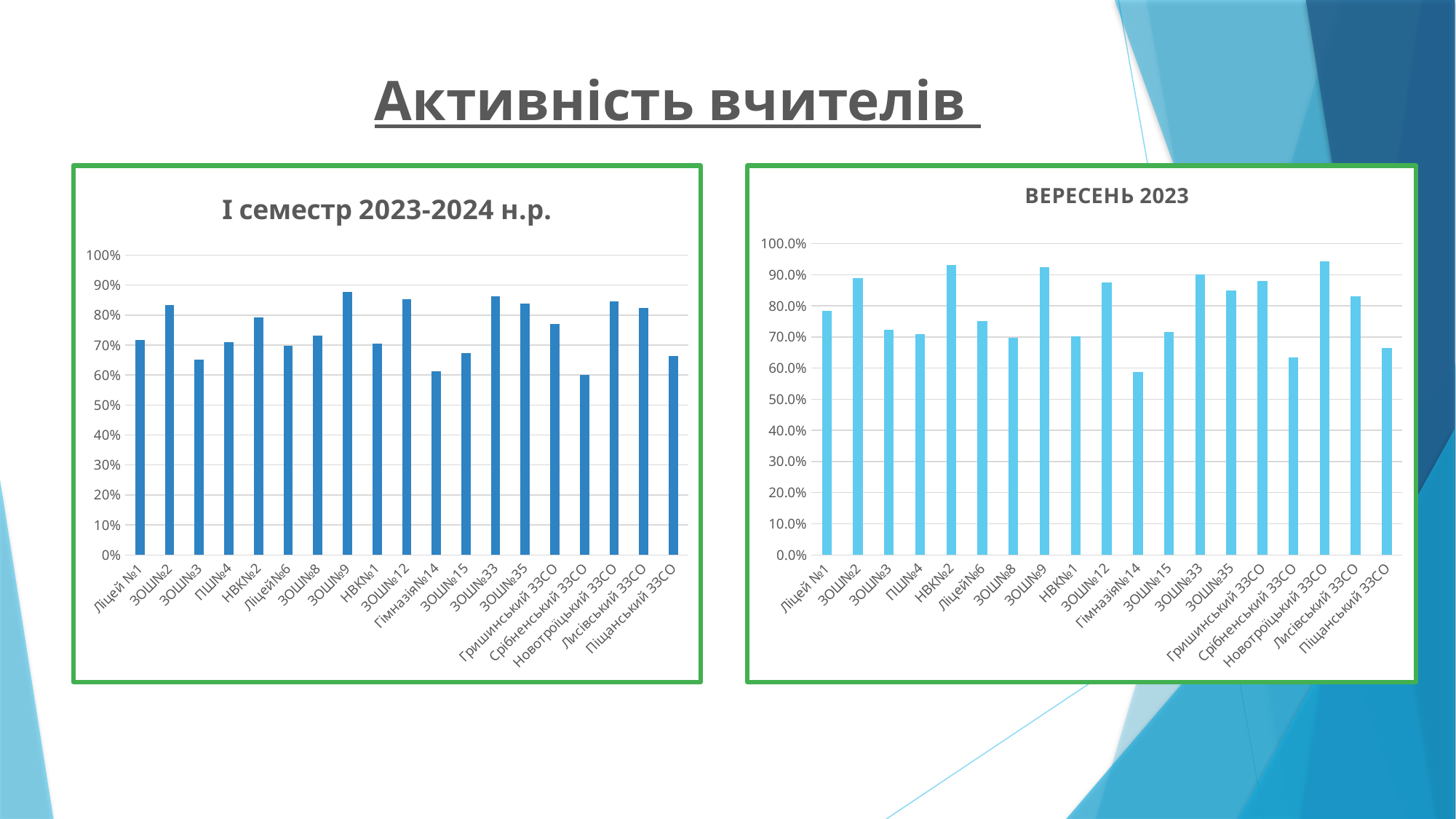
On the right chart "ВЕРЕСЕНЬ 2023", is the value for Срібненський ЗЗСО greater or less than 70.0%? less On the right chart "ВЕРЕСЕНЬ 2023", which is larger: the value for ЗОШ№9 or for ЗОШ№8? ЗОШ№9 How many schools (categories) are shown on the left chart "І семестр 2023-2024 н.р."? 19 What is the title of the slide? Активність вчителів On the left chart "І семестр 2023-2024 н.р.", is the value for ЗОШ№9 greater or less than 80%? greater What is the title of the right chart on the slide? ВЕРЕСЕНЬ 2023 On the left chart "І семестр 2023-2024 н.р.", which is larger: the value for ЗОШ№2 or for ЗОШ№3? ЗОШ№2 On the right chart "ВЕРЕСЕНЬ 2023", which school has the lowest value? Гімназія№14 How many categories are plotted on the right chart "ВЕРЕСЕНЬ 2023"? 19 What kind of chart is the left chart titled "І семестр 2023-2024 н.р."? Bar chart On the left chart "І семестр 2023-2024 н.р.", is the value for ЗОШ№3 greater or less than 70%? less